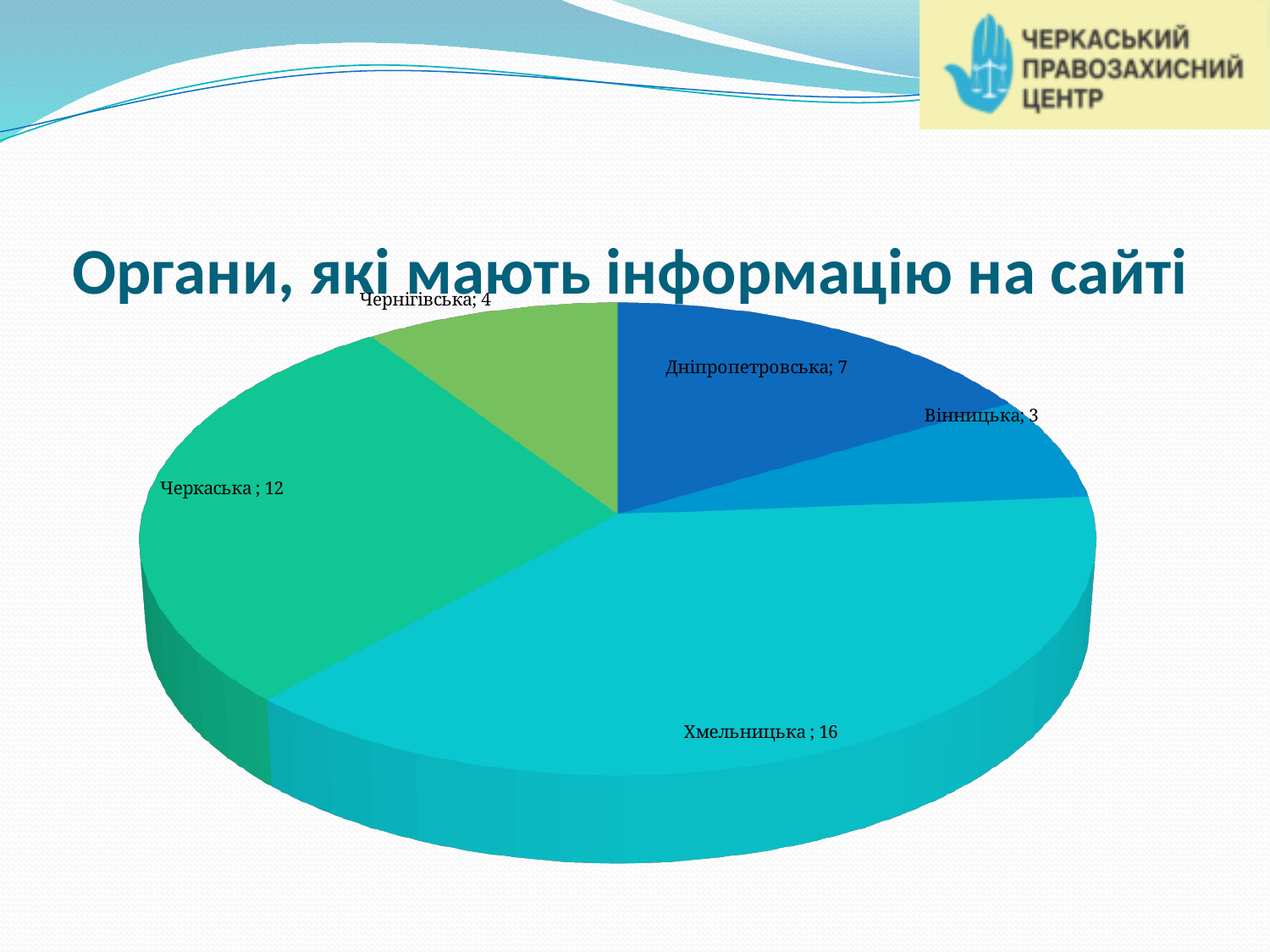
What is the value for Дніпропетровська? 7 What is the value for Хмельницька? 16 Which category has the smallest slice? Вінницька What is the difference between the values for Хмельницька and Черкаська? 4 What is the value for Вінницька? 3 What type of chart is shown on the slide? pie chart Which category has the largest slice? Хмельницька What is the value for Черкаська? 12 What is the title of the chart? Органи, які мають інформацію на сайті How many categories are shown in the pie chart? 5 Which is larger, the value for Дніпропетровська or the value for Чернігівська? Дніпропетровська